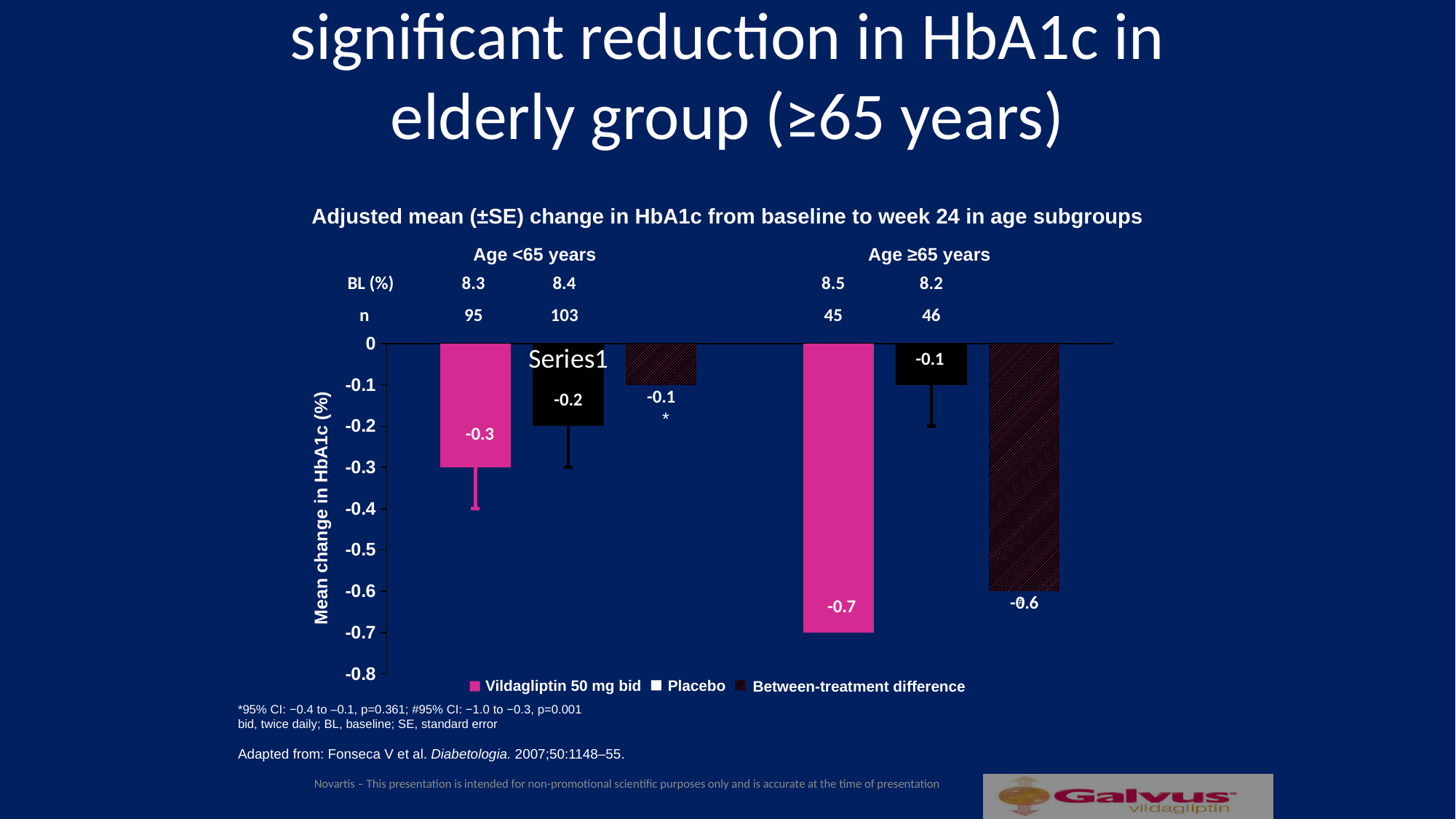
What is the mean change in HbA1c for Vildagliptin 50 mg bid in the Age ≥65 years group? -0.7 What type of chart is shown on the slide? Bar chart What is the mean change in HbA1c for Placebo in the Age ≥65 years group? -0.1 What is the difference between the Vildagliptin and Placebo mean changes in HbA1c in the Age <65 years group? 0.1 What is the mean change in HbA1c for Vildagliptin 50 mg bid in the Age <65 years group? -0.3 What is the between-treatment difference shown for the Age ≥65 years group? -0.6 What is the baseline HbA1c (BL %) shown for the Vildagliptin group aged ≥65 years? 8.5 Which shows a larger reduction in HbA1c in the Age ≥65 years group: Vildagliptin 50 mg bid or Placebo? Vildagliptin 50 mg bid What is the mean change in HbA1c for Placebo in the Age <65 years group? -0.2 Which bar shows the largest reduction in HbA1c on the chart? Vildagliptin 50 mg bid, Age ≥65 years How many series does the chart legend list? 3 What is the label of the vertical axis of the chart? Mean change in HbA1c (%)